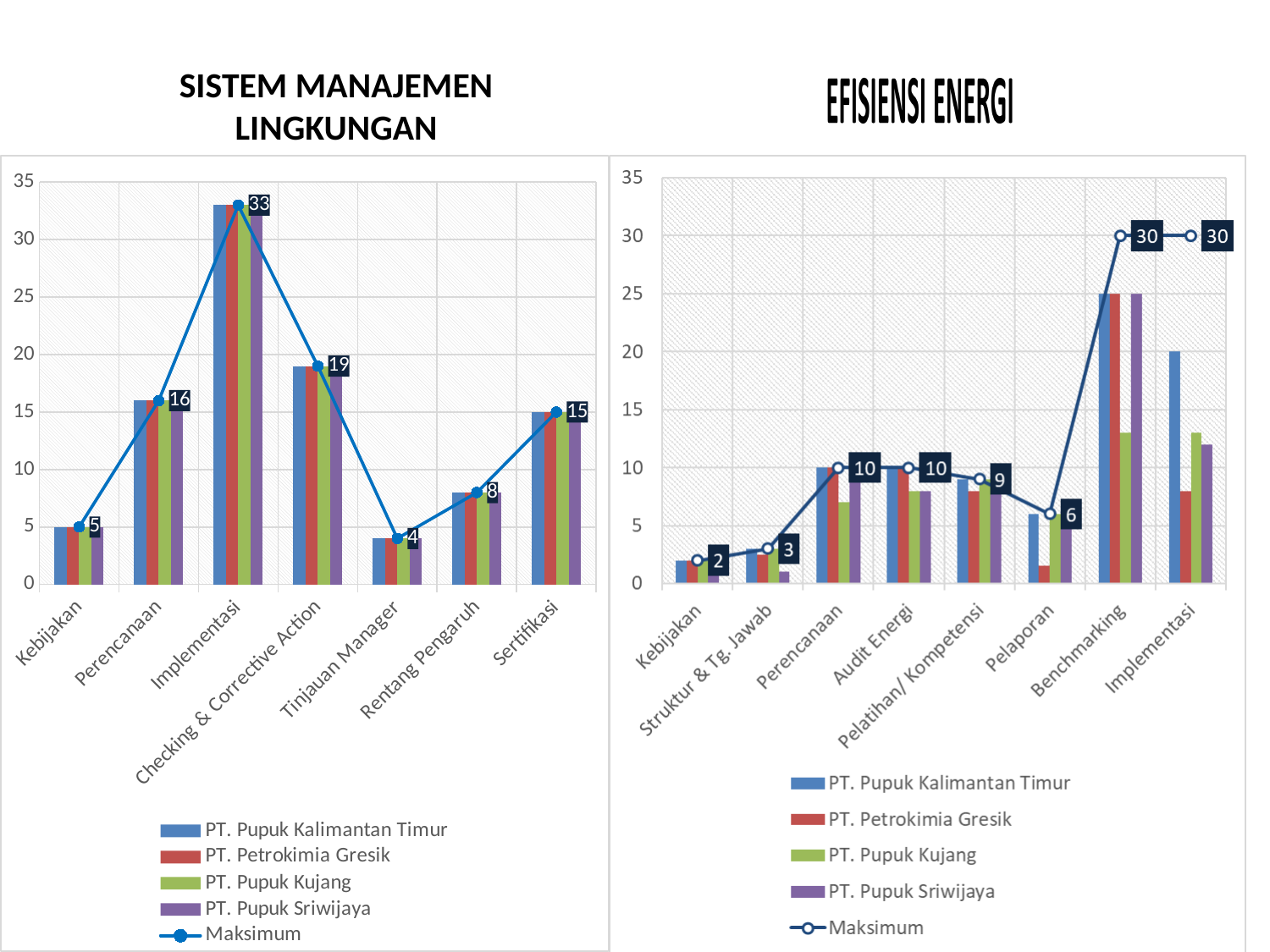
How many series does the legend of the EFISIENSI ENERGI chart list? 5 In the SISTEM MANAJEMEN LINGKUNGAN chart, what is the Maksimum value for Tinjauan Manager? 4 In the EFISIENSI ENERGI chart, is the value for PT. Pupuk Kalimantan Timur at Implementasi greater or less than 15? greater In the SISTEM MANAJEMEN LINGKUNGAN chart, what is the difference between the Maksimum values for Checking & Corrective Action and Sertifikasi? 4 In the EFISIENSI ENERGI chart, is the Maksimum value for Perencanaan or Pelatihan/ Kompetensi larger? Perencanaan In the EFISIENSI ENERGI chart, what is the Maksimum value for Pelaporan? 6 In the EFISIENSI ENERGI chart, which category has the lowest Maksimum value? Kebijakan In the SISTEM MANAJEMEN LINGKUNGAN chart, which category has the highest Maksimum value? Implementasi In the EFISIENSI ENERGI chart, is the value for PT. Petrokimia Gresik at Pelaporan greater or less than 5? less In the SISTEM MANAJEMEN LINGKUNGAN chart, what is the Maksimum value for Implementasi? 33 What kind of chart is the SISTEM MANAJEMEN LINGKUNGAN chart? Bar chart with a line series In the SISTEM MANAJEMEN LINGKUNGAN chart, how many categories are shown on the x axis? 7